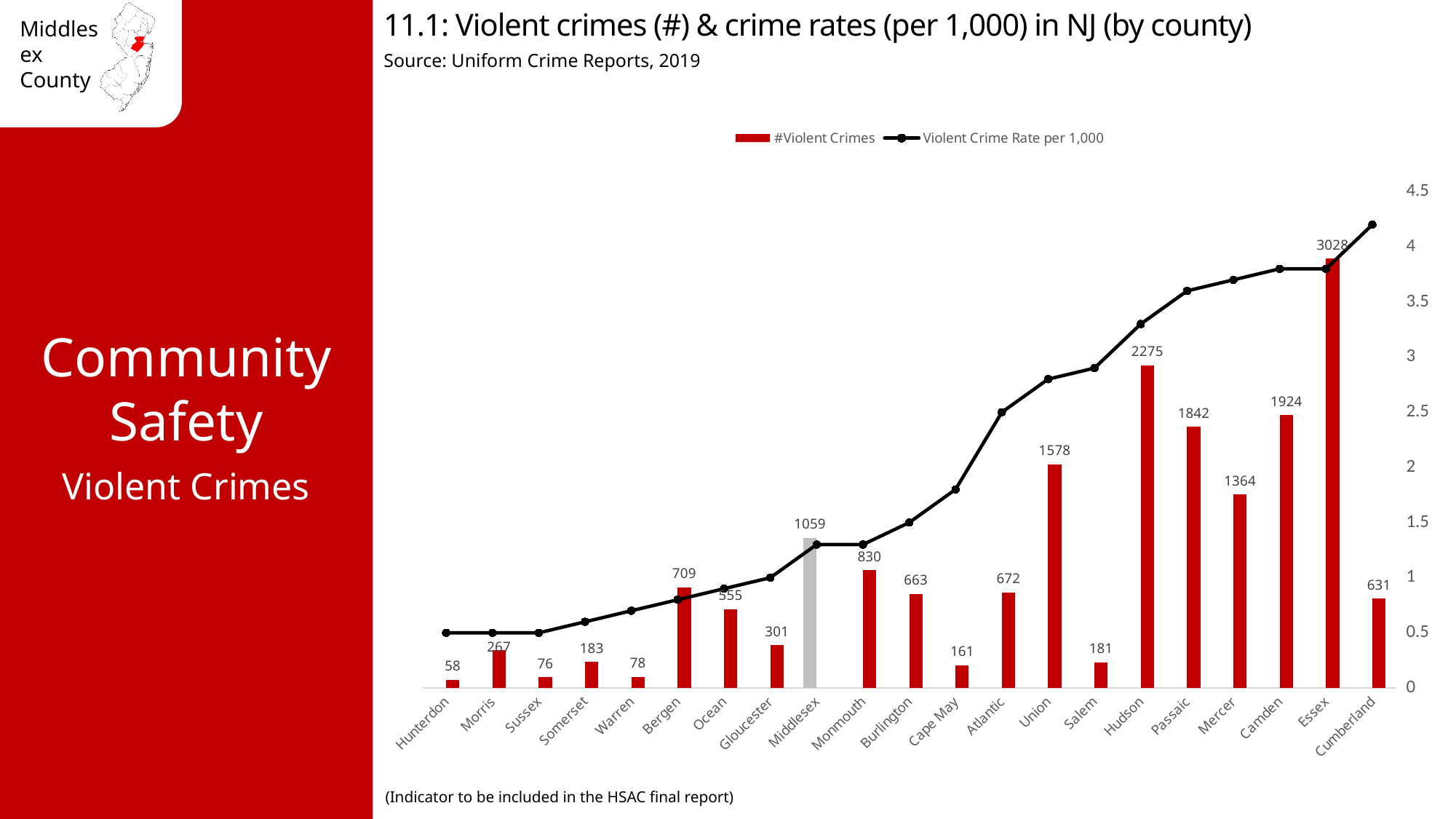
Is the violent crime rate per 1,000 for Cumberland greater or less than 4? greater What is the number of violent crimes for Middlesex? 1059 Is the violent crime rate per 1,000 for Union greater or less than 2.5? greater Which county has the highest number of violent crimes? Essex Which county has the lowest number of violent crimes? Hunterdon What is the number of violent crimes for Essex? 3028 What kind of chart is this? Combined bar and line chart Does the violent crime rate per 1,000 line rise or fall from Hunterdon to Cumberland? Rise How many counties are shown on the x axis? 21 How many series does the legend list? 2 What is the difference in the number of violent crimes between Hudson and Passaic? 433 Which county has more violent crimes, Camden or Passaic? Camden